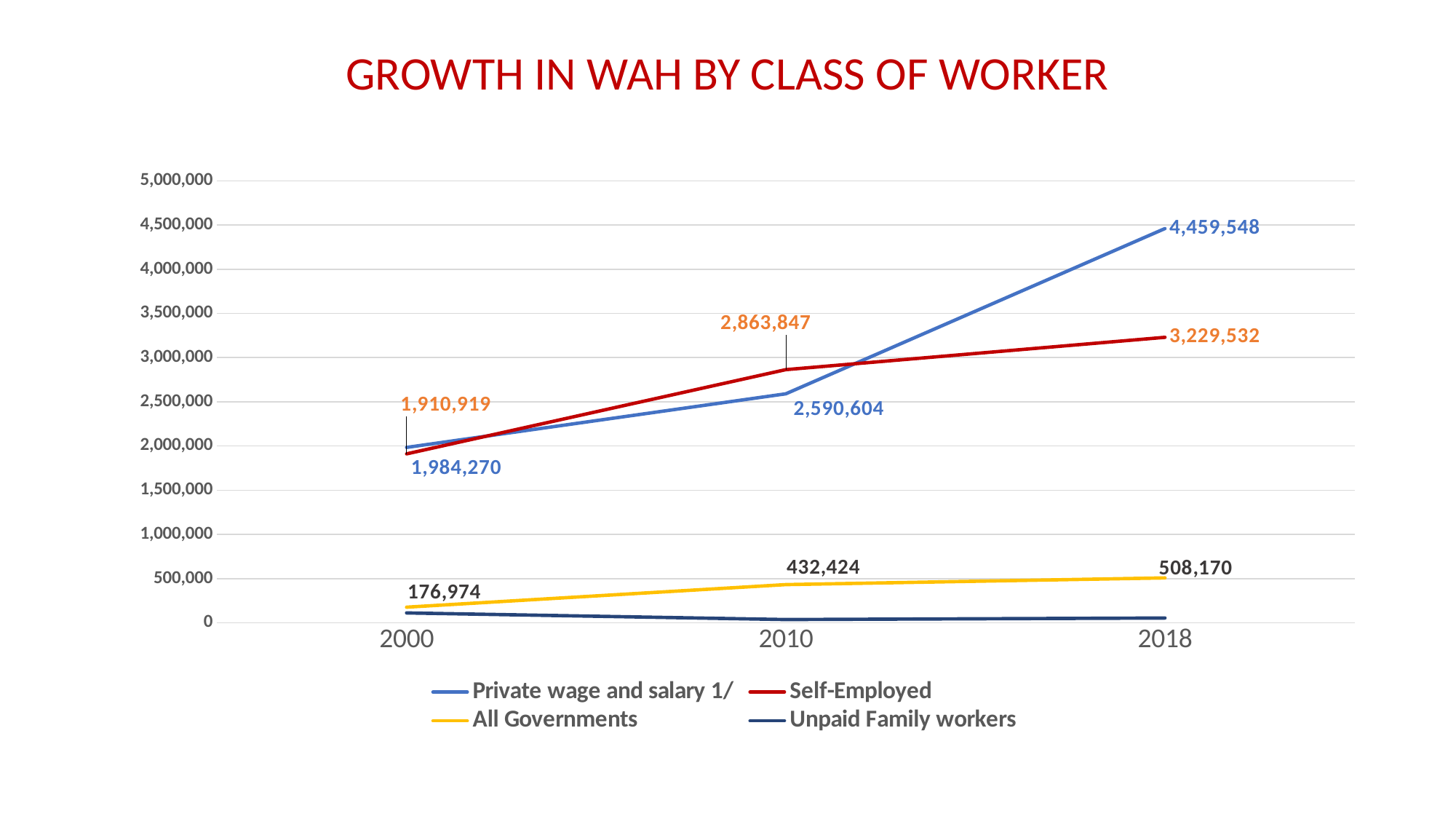
What is the value for Self-Employed in 2010? 2,863,847 Does the All Governments series rise or fall from 2000 to 2018? rise Which series has the lowest value in 2010? Unpaid Family workers Is the value for Unpaid Family workers in 2000 greater or less than 500,000? less What is the value for Private wage and salary 1/ in 2018? 4,459,548 What is the value for All Governments in 2000? 176,974 What is the difference between the Private wage and salary 1/ values in 2018 and 2010? 1,868,944 How many series does the legend list? 4 How many years are plotted along the x axis? 3 In 2010, which is larger: Private wage and salary 1/ or Self-Employed? Self-Employed Which series has the highest value in 2018? Private wage and salary 1/ What type of chart is shown on the slide? line chart